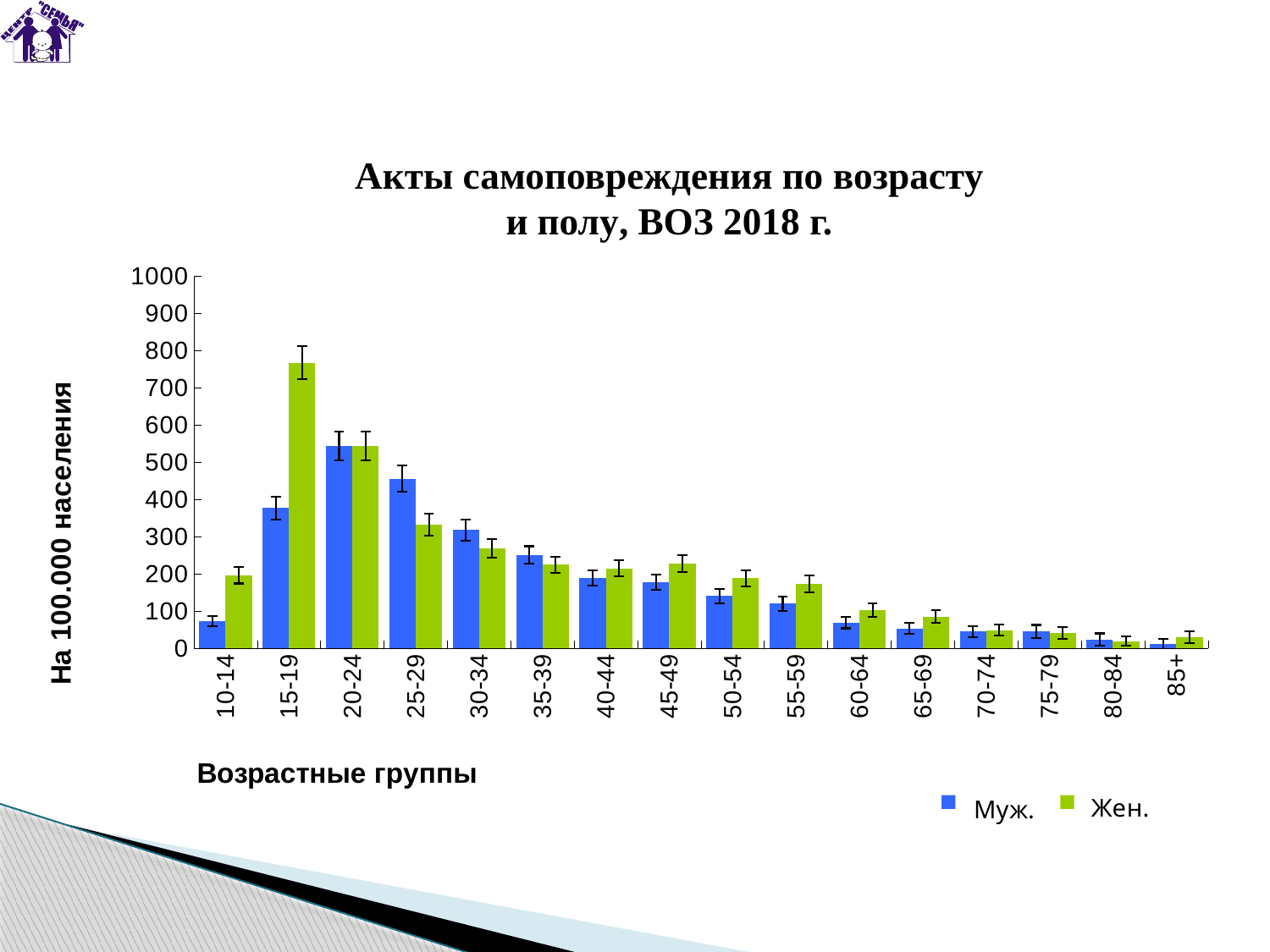
Which age group has the highest value for the Жен. series? 15-19 In the 10-14 age group, which series has the larger value, Муж. or Жен.? Жен. How many series does the legend list? 2 Is the Жен. value for the 15-19 age group greater or less than 700? greater Is the Муж. value for the 10-14 age group greater or less than 100? less Is the Муж. value for the 20-24 age group greater or less than 500? greater Which age group has the highest value for the Муж. series? 20-24 What kind of chart is shown on the slide? bar chart In the 25-29 age group, which series has the larger value, Муж. or Жен.? Муж. How many age groups are shown on the x axis? 16 What is the label of the y axis? На 100.000 населения